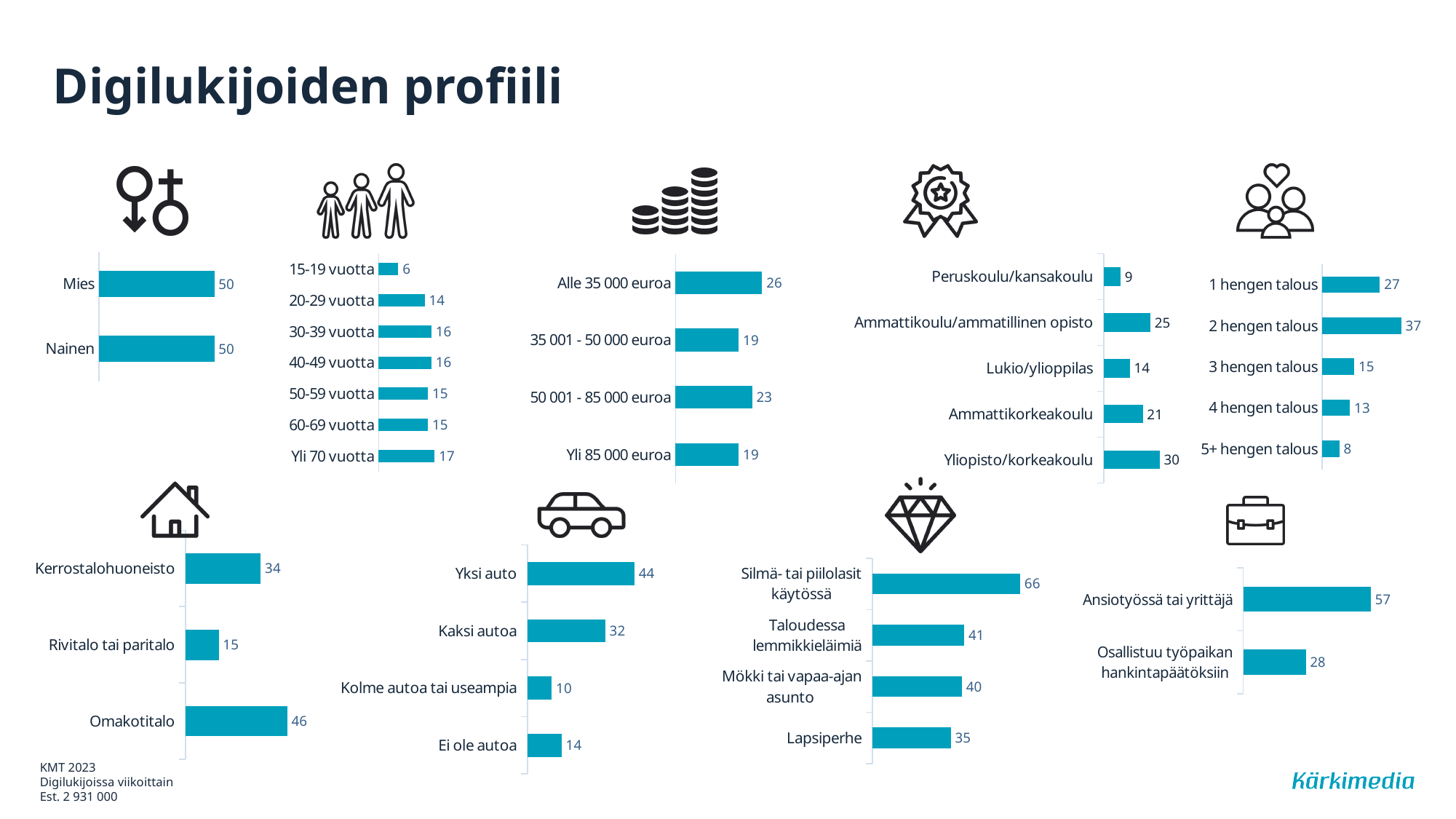
What is the title of the slide? Digilukijoiden profiili In the lifestyle chart (bottom row, third from left, with the diamond icon), what is the value for Lapsiperhe? 35 In the car chart (bottom row, second from left, with the car icon), how many categories are shown? 4 In the housing chart (bottom left, with the house icon), which is larger: Kerrostalohuoneisto or Omakotitalo? Omakotitalo In the education chart (top row, fourth from left), what is the value for Yliopisto/korkeakoulu? 30 In the work chart (bottom right, with the briefcase icon), what is the value for Ansiotyössä tai yrittäjä? 57 In the income chart (top row, middle, with the coins icon), which category has the highest value? Alle 35 000 euroa In the gender chart (top left), what is the value for Nainen? 50 What kind of chart is used for the age breakdown (top row, second from left)? Bar chart In the education chart (top row, fourth from left, with the badge icon), which category has the lowest value? Peruskoulu/kansakoulu In the age chart (top row, second from left, with the people icon), what is the value for 20-29 vuotta? 14 In the household size chart (top right, with the family icon), what is the difference between 2 hengen talous and 1 hengen talous? 10